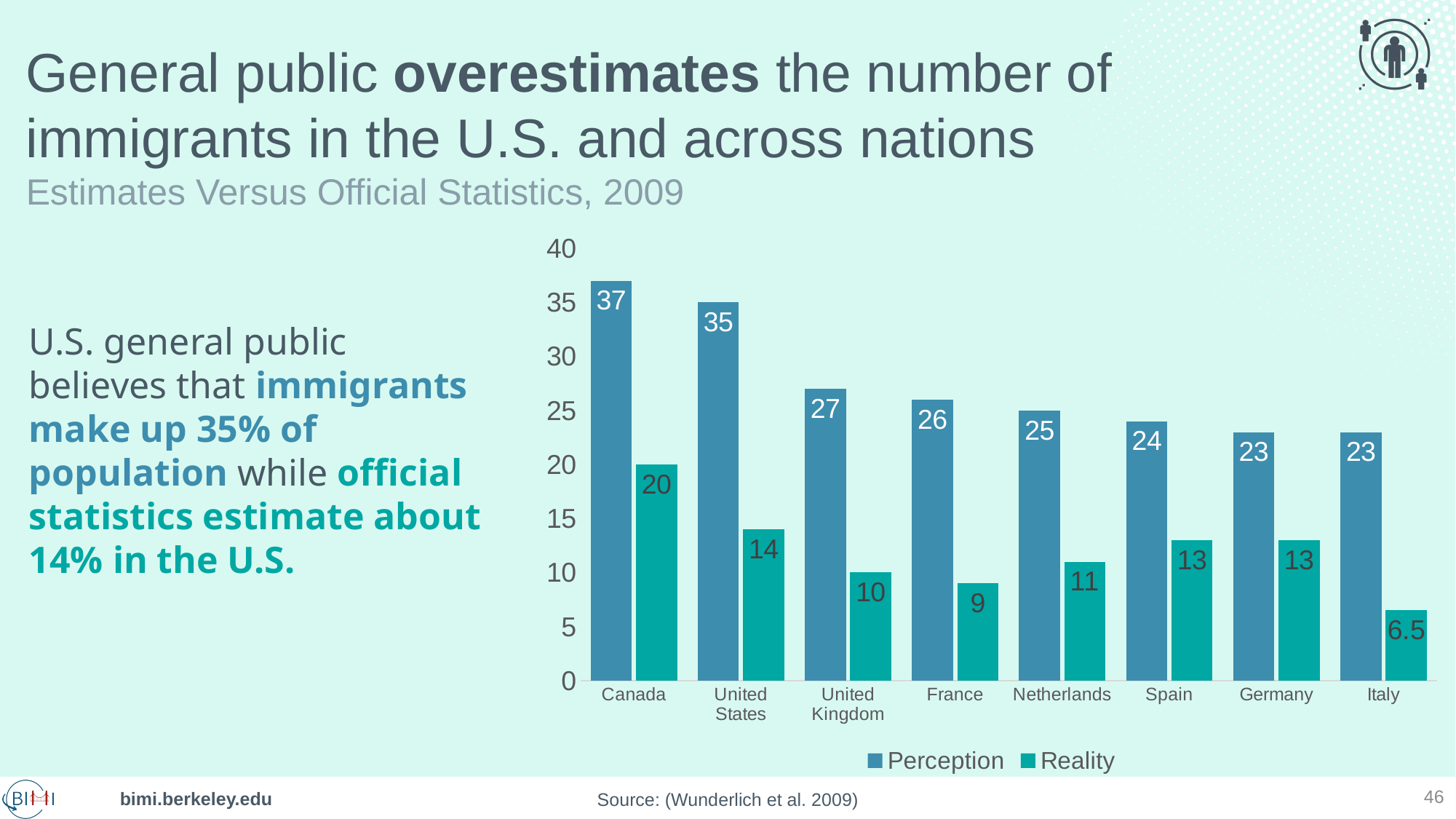
What is the Perception value for Canada? 37 What is the Reality value for Italy? 6.5 What are the two series named in the legend? Perception and Reality What is the Reality value for the United States? 14 Which country has the highest Perception value? Canada How many countries are shown on the x axis? 8 How many series does the legend list? 2 What is the difference between the Perception and Reality values for the United States? 21 Is the Perception value for France greater or less than 20? greater Which is larger, the Reality value for Canada or the Reality value for Spain? Canada What kind of chart is shown on the slide? bar chart Which country has the lowest Reality value? Italy